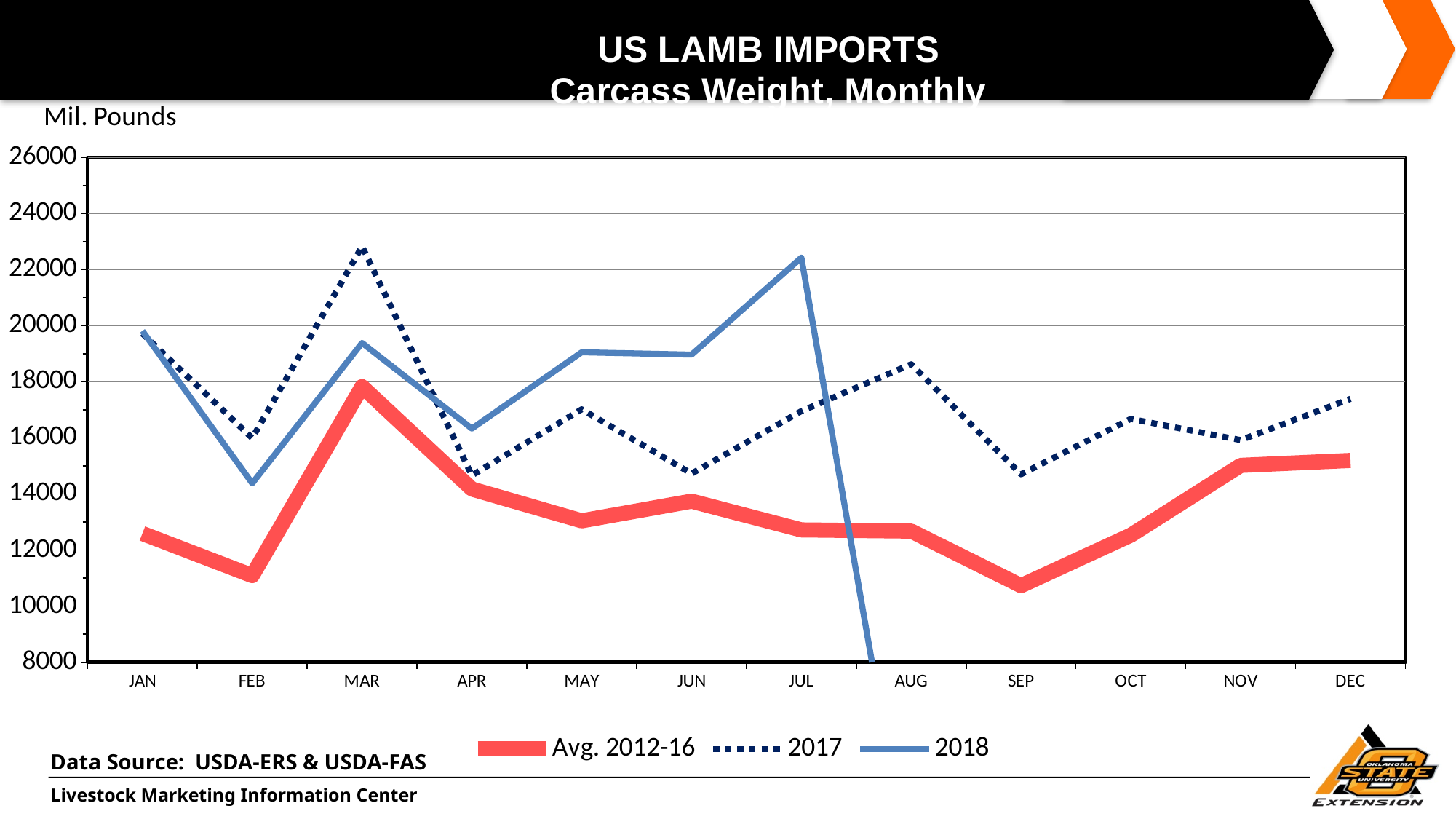
What unit is shown on the y axis label? Mil. Pounds In MAY, which series has the larger value, 2017 or 2018? 2018 Is the value for 2017 in MAR greater or less than 22000? greater In which month does the Avg. 2012-16 series reach its lowest value? SEP How many months are shown along the x axis? 12 How many series does the legend list? 3 What kind of chart is shown on the slide? line chart In which month does the 2017 series reach its highest value? MAR Is the value for Avg. 2012-16 in FEB greater or less than 12000? less Does the Avg. 2012-16 series rise or fall from SEP to DEC? rise Is the value for 2018 in JUL greater or less than 20000? greater In which month does the 2018 series reach its highest value? JUL